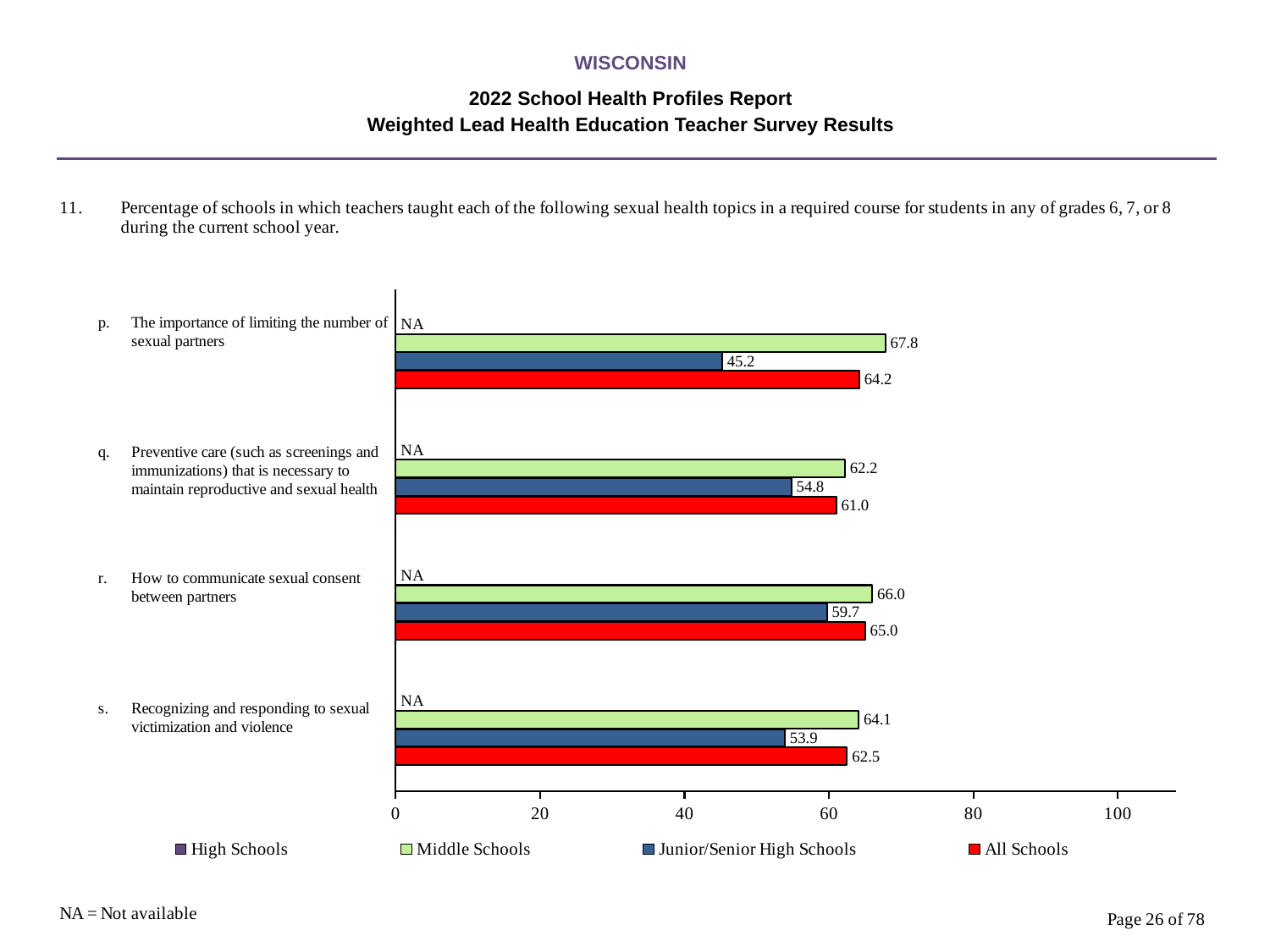
How many topics are listed on the chart? 4 What is shown for High Schools for 'Recognizing and responding to sexual victimization and violence'? NA Is the Junior/Senior High Schools value for 'How to communicate sexual consent between partners' greater or less than 40? greater What is the All Schools value for 'How to communicate sexual consent between partners'? 65.0 For 'Recognizing and responding to sexual victimization and violence', which is larger: the Middle Schools value or the All Schools value? Middle Schools How many series does the legend list? 4 What kind of chart is shown on the slide? bar chart What is the Middle Schools value for 'The importance of limiting the number of sexual partners'? 67.8 Which topic has the highest Middle Schools value? The importance of limiting the number of sexual partners What is the difference between the Middle Schools and Junior/Senior High Schools values for 'The importance of limiting the number of sexual partners'? 22.6 Which topic has the lowest Junior/Senior High Schools value? The importance of limiting the number of sexual partners What is the Junior/Senior High Schools value for 'Preventive care (such as screenings and immunizations) that is necessary to maintain reproductive and sexual health'? 54.8